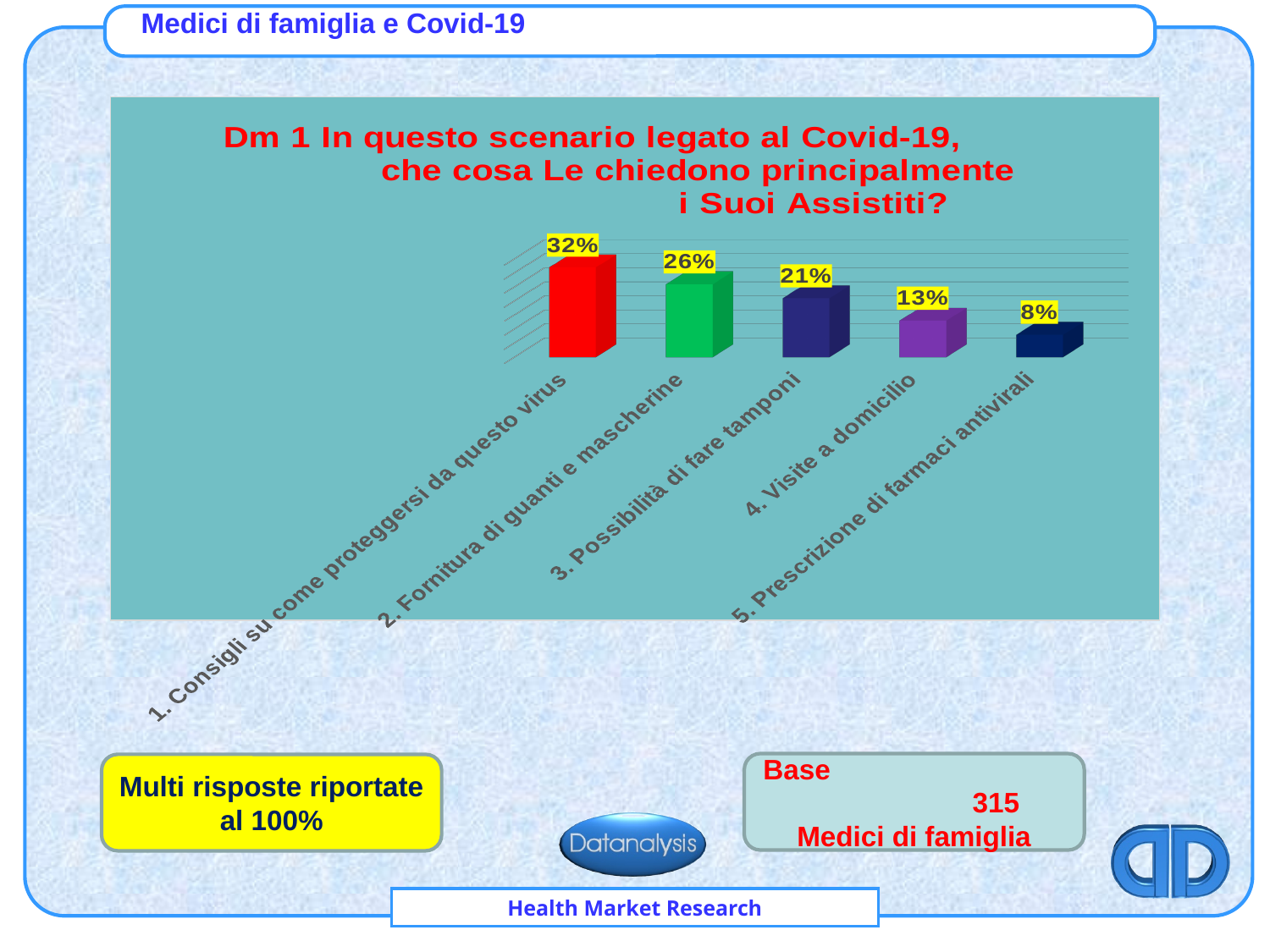
Which category has the highest value? 1. Consigli su come proteggersi da questo virus What kind of chart is shown on the slide? bar chart What is the value for "4. Visite a domicilio"? 13% How many categories are shown in the chart? 5 What is the value for "3. Possibilità di fare tamponi"? 21% What is the difference between the values for "1. Consigli su come proteggersi da questo virus" and "2. Fornitura di guanti e mascherine"? 6% What is the value for "2. Fornitura di guanti e mascherine"? 26% What is the value for "5. Prescrizione di farmaci antivirali"? 8% Which is larger, the value for "3. Possibilità di fare tamponi" or the value for "4. Visite a domicilio"? 3. Possibilità di fare tamponi Do the values rise or fall from left to right across the categories? fall Which category has the lowest value? 5. Prescrizione di farmaci antivirali What is the value for "1. Consigli su come proteggersi da questo virus"? 32%